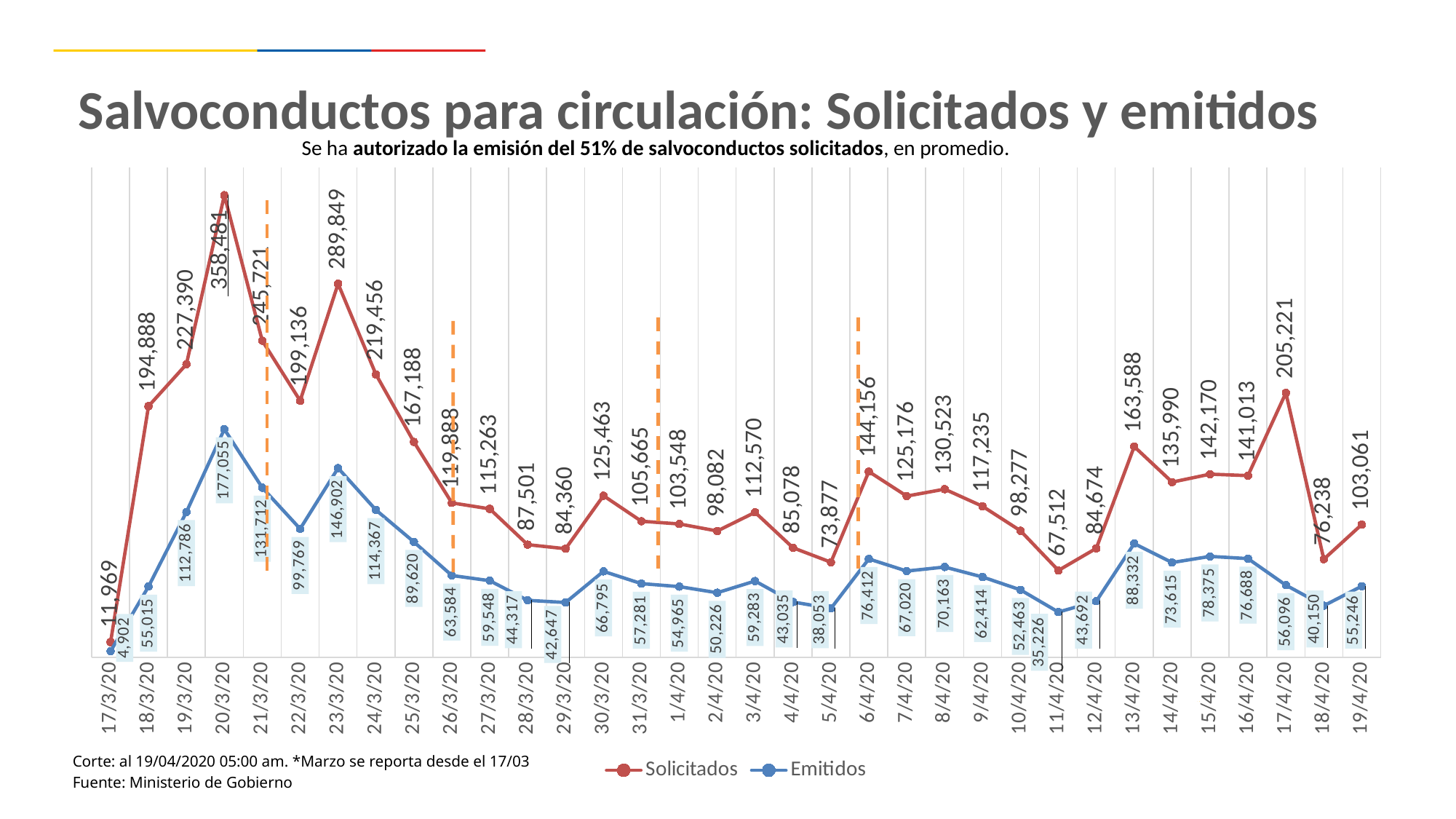
How many dates are plotted on the x axis? 34 What is the value of Solicitados on 20/3/20? 358,481 What is the difference between Solicitados and Emitidos on 19/4/20? 47,815 What is the difference between Solicitados and Emitidos on 20/3/20? 181,426 What type of chart is shown on the slide? Line chart What is the value of Solicitados on 17/4/20? 205,221 On which date is the Solicitados value highest? 20/3/20 On which date is the Emitidos value lowest? 17/3/20 What is the value of Emitidos on 23/3/20? 146,902 How many series does the legend list? 2 Which is larger, the Solicitados value on 13/4/20 or on 14/4/20? 13/4/20 According to the subtitle, what average percentage of requested salvoconductos has been authorized? 51%